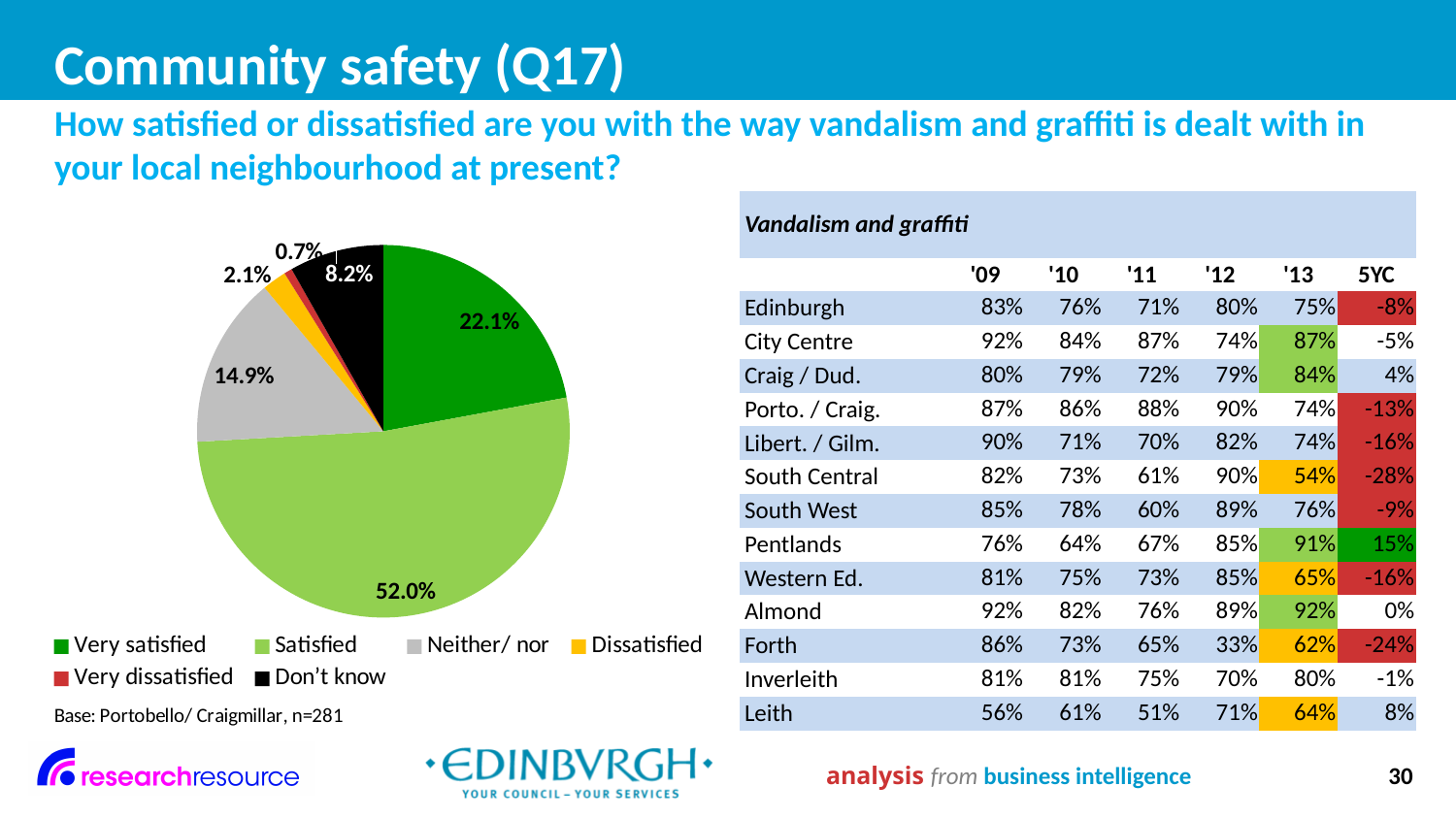
What percentage of respondents are 'Very satisfied' in the pie chart? 22.1% What type of chart is shown on the slide? Pie chart What is the base (sample size) stated below the pie chart? Portobello/ Craigmillar, n=281 Which category has the largest slice in the pie chart? Satisfied What share of the pie chart is 'Neither/ nor'? 14.9% Which category has the smallest slice in the pie chart? Very dissatisfied How many categories does the pie chart legend list? 6 What percentage of respondents answered 'Don't know' in the pie chart? 8.2% What is the difference between the 'Satisfied' and 'Very satisfied' percentages in the pie chart? 29.9% Which is larger in the pie chart: 'Don't know' or 'Dissatisfied'? Don't know What percentage of respondents are 'Very dissatisfied' in the pie chart? 0.7% What percentage of respondents are 'Satisfied' in the pie chart? 52.0%